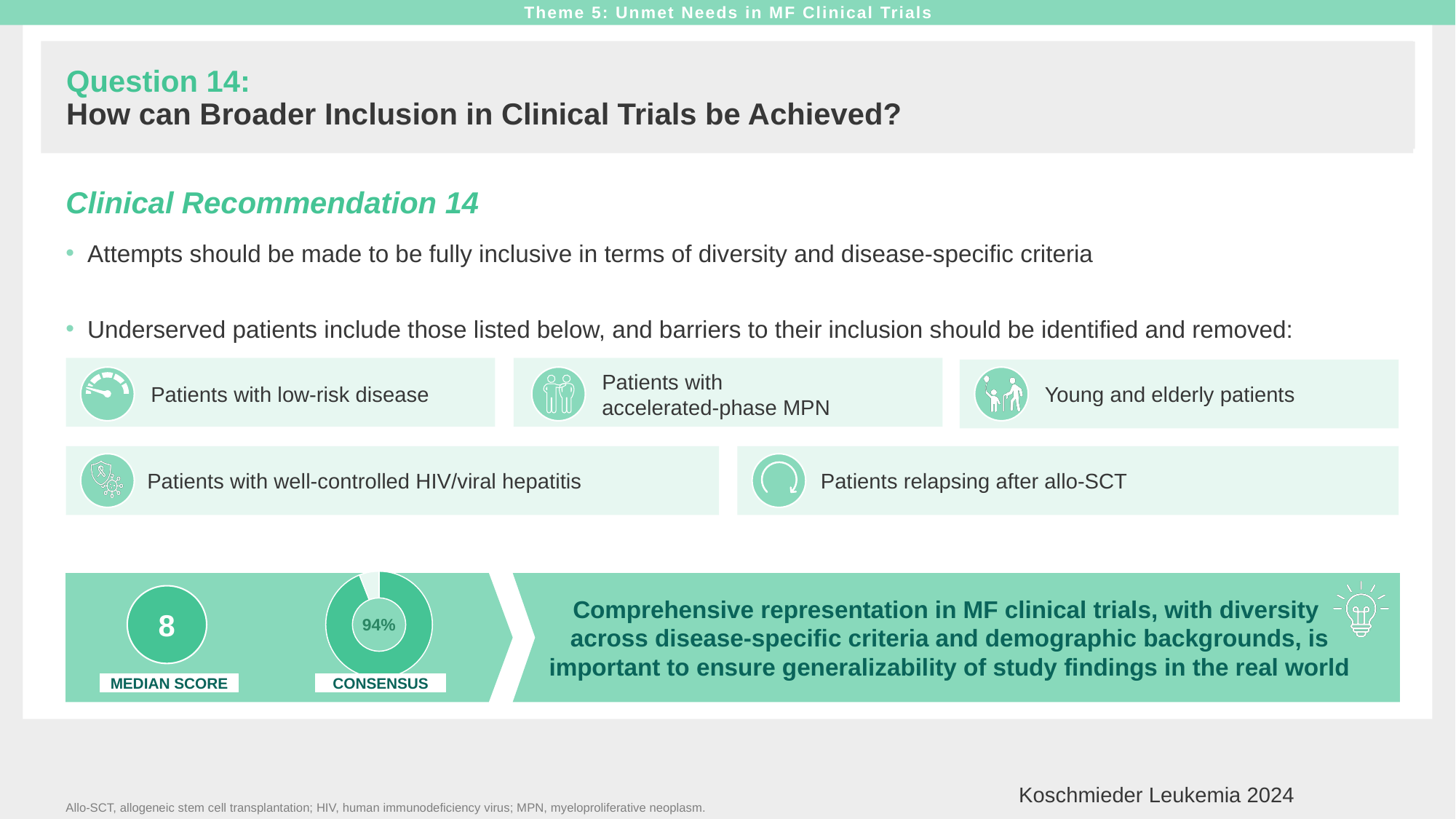
How many segments does the consensus donut chart have? 2 Is the filled share of the consensus donut chart greater or less than 50%? greater Which segment of the consensus donut chart is larger, the darker green filled segment or the light unfilled segment? the darker green filled segment What share of the consensus donut chart is filled by the darker green segment? 94% What label appears beneath the donut chart? CONSENSUS What percentage is shown in the centre of the donut chart labelled CONSENSUS? 94% What kind of chart is used to display the consensus value? donut (pie) chart